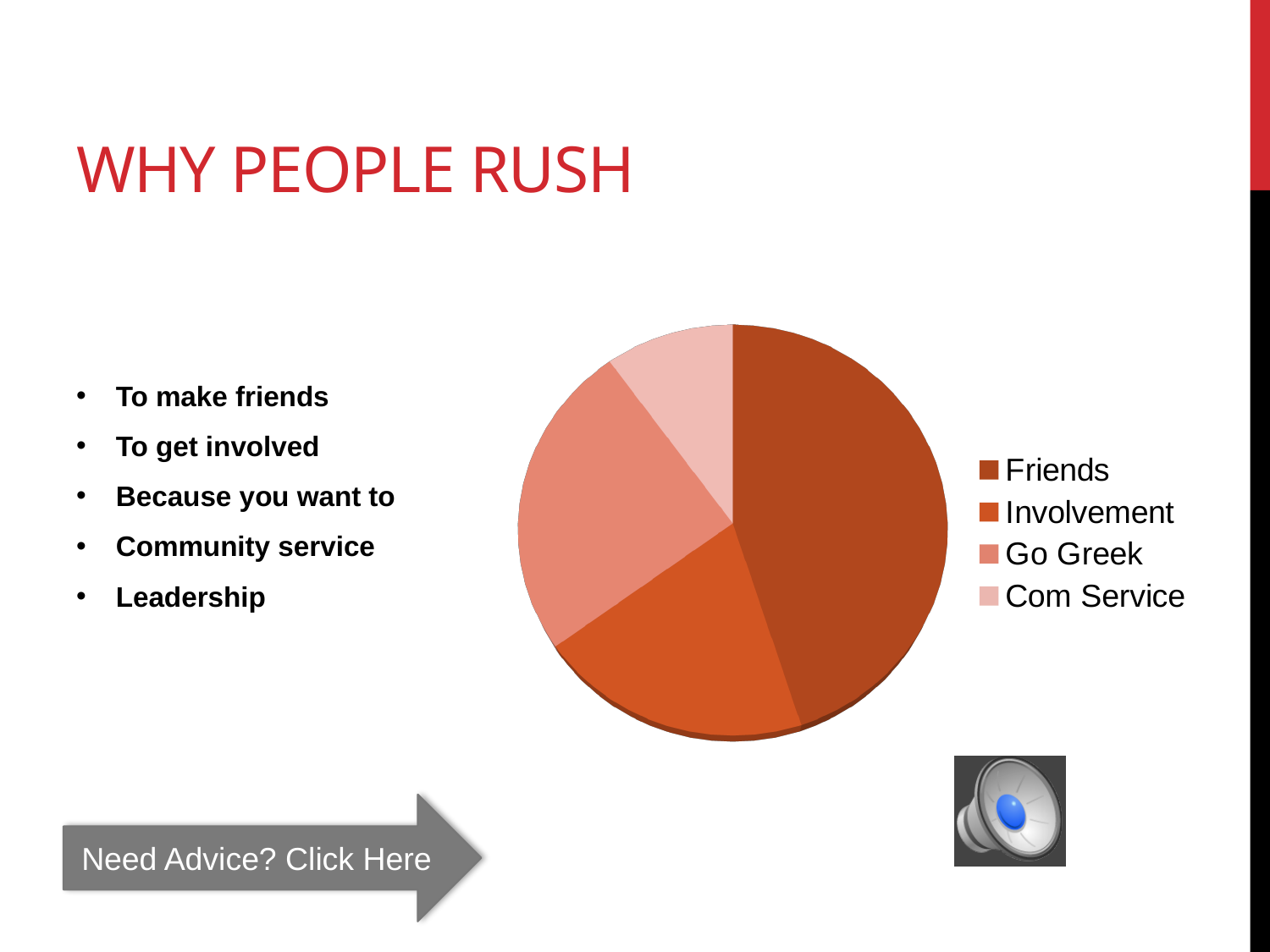
Which slice is larger in the pie chart, Friends or Com Service? Friends Which category has the largest slice of the pie chart? Friends Which slice is larger in the pie chart, Go Greek or Com Service? Go Greek Which slice is larger in the pie chart, Friends or Involvement? Friends How many entries does the pie chart's legend list? 4 Which category has the smallest slice of the pie chart? Com Service Which legend entry of the pie chart is shown in the lightest colour? Com Service What kind of chart is shown on the slide? Pie chart How many slices does the pie chart have? 4 What are the legend entries of the pie chart, in order? Friends, Involvement, Go Greek, Com Service